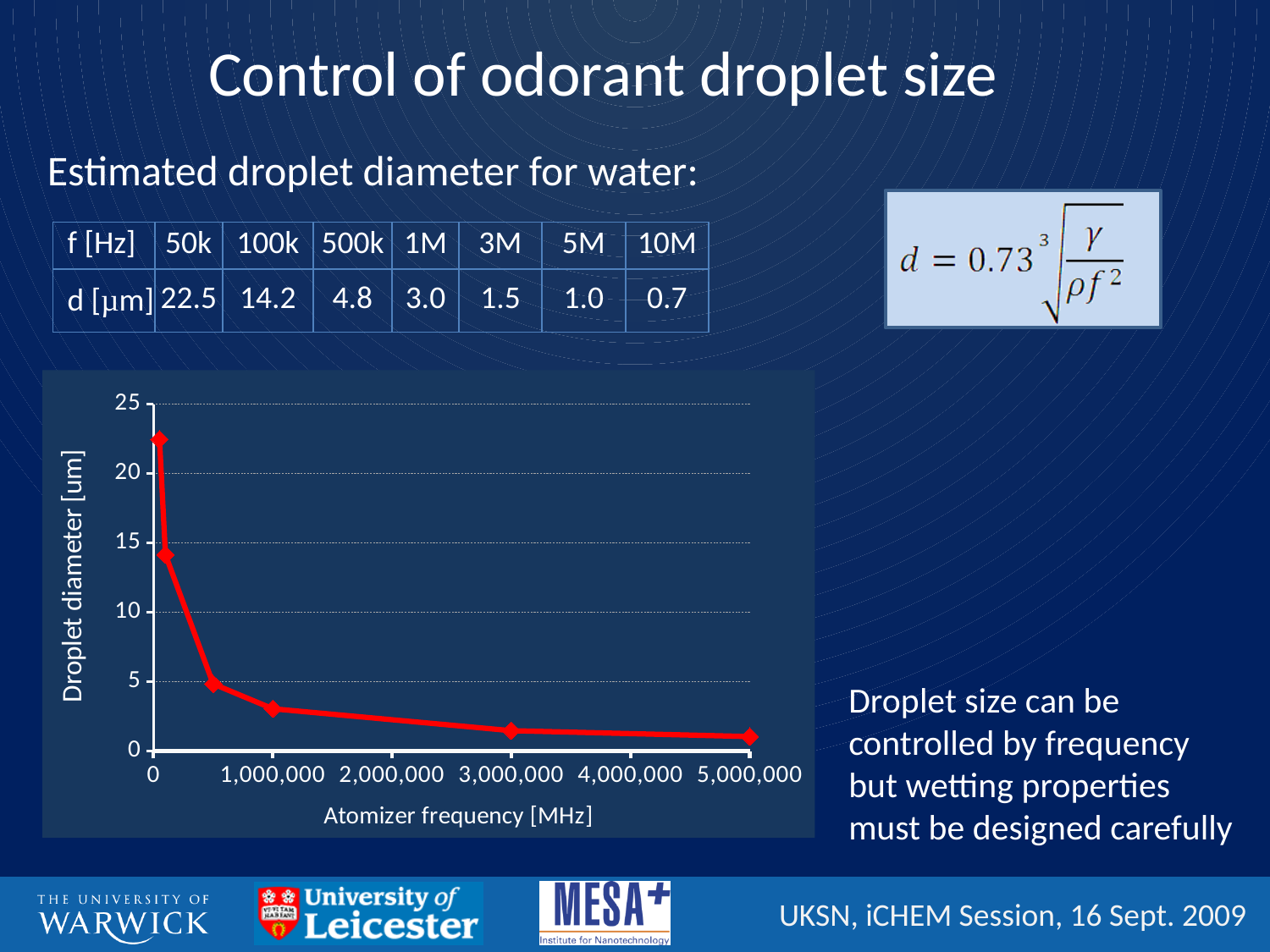
What is the highest value labelled on the y axis of the chart? 25 Is the droplet diameter of the first (leftmost) data point greater or less than 20? greater Is the droplet diameter at an atomizer frequency of 5,000,000 greater or less than 5? less What kind of chart is shown on the slide? line chart At which x-axis value does the plotted line reach its lowest droplet diameter? 5,000,000 What is the title of the x axis of the chart? Atomizer frequency [MHz] What is the title of the y axis of the chart? Droplet diameter [um] How many data points are plotted on the line in the chart? 6 Is the droplet diameter of the second data point from the left greater or less than 10? greater Does the droplet diameter rise or fall as atomizer frequency increases along the x axis? fall Which is larger, the droplet diameter at 1,000,000 or at 3,000,000 on the x axis? 1,000,000